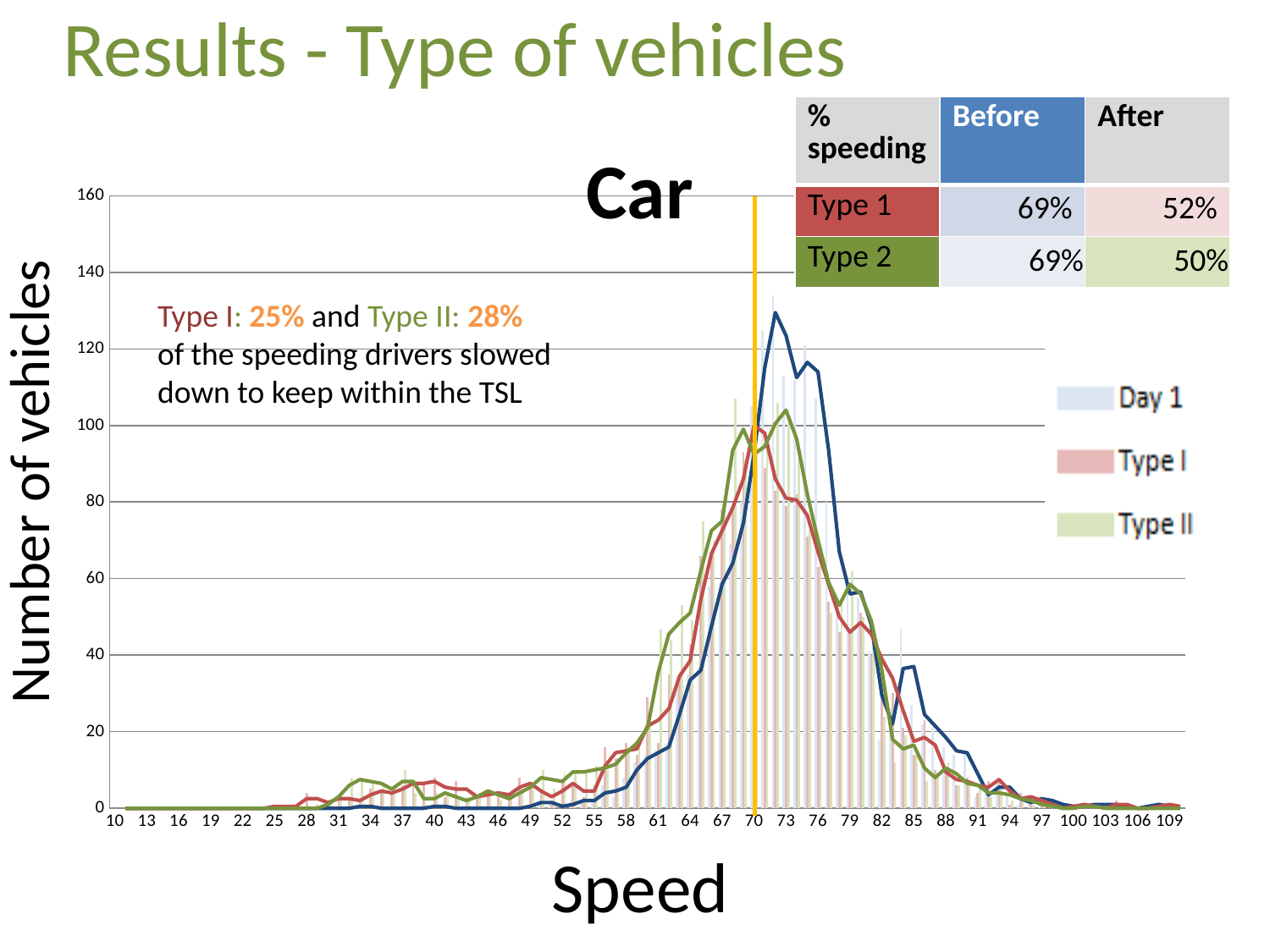
What kind of chart is shown on the slide? line chart Which series reaches the highest peak value? Day 1 How many series does the chart legend list? 3 What is the title of the chart? Car Do the values of the Day 1 series rise or fall between speed 58 and speed 70? rise At speed 85, which series has the larger value, Day 1 or Type I? Day 1 At speed 61, which series has the larger value, Type II or Day 1? Type II What is the label of the y axis? Number of vehicles Is the peak value of the Day 1 series greater or less than 120? greater What is the value of the Day 1 series at speed 10? 0 Is the peak value of the Type II series greater or less than 120? less Is the peak value of the Type I series greater or less than 80? greater